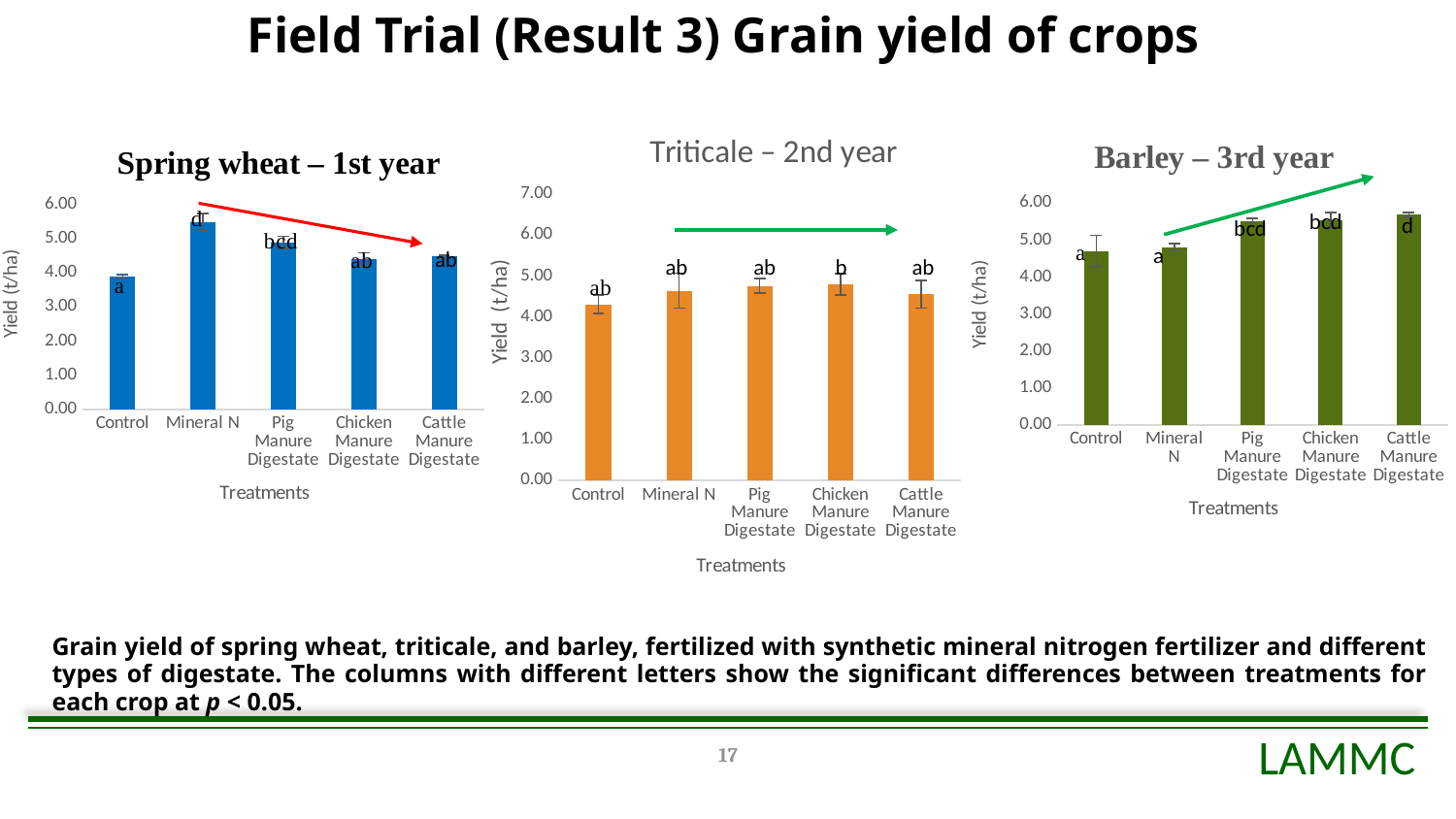
What type of chart is the Barley – 3rd year chart? Bar chart In the Spring wheat – 1st year chart, is the yield for Control greater or less than 4.00? less In the Spring wheat – 1st year chart, is the yield for Mineral N greater or less than 5.00? greater In the Barley – 3rd year chart, is the yield for Cattle Manure Digestate greater or less than 5.00? greater How many treatments are shown on the x axis of the Triticale – 2nd year chart? 5 In the Spring wheat – 1st year chart, which treatment has the highest grain yield? Mineral N In the Spring wheat – 1st year chart, what significance letter is shown above the Mineral N bar? d In the Barley – 3rd year chart, which treatment has the highest grain yield? Cattle Manure Digestate In the Triticale – 2nd year chart, which treatment has the lowest grain yield? Control In the Spring wheat – 1st year chart, which treatment has the lowest grain yield? Control